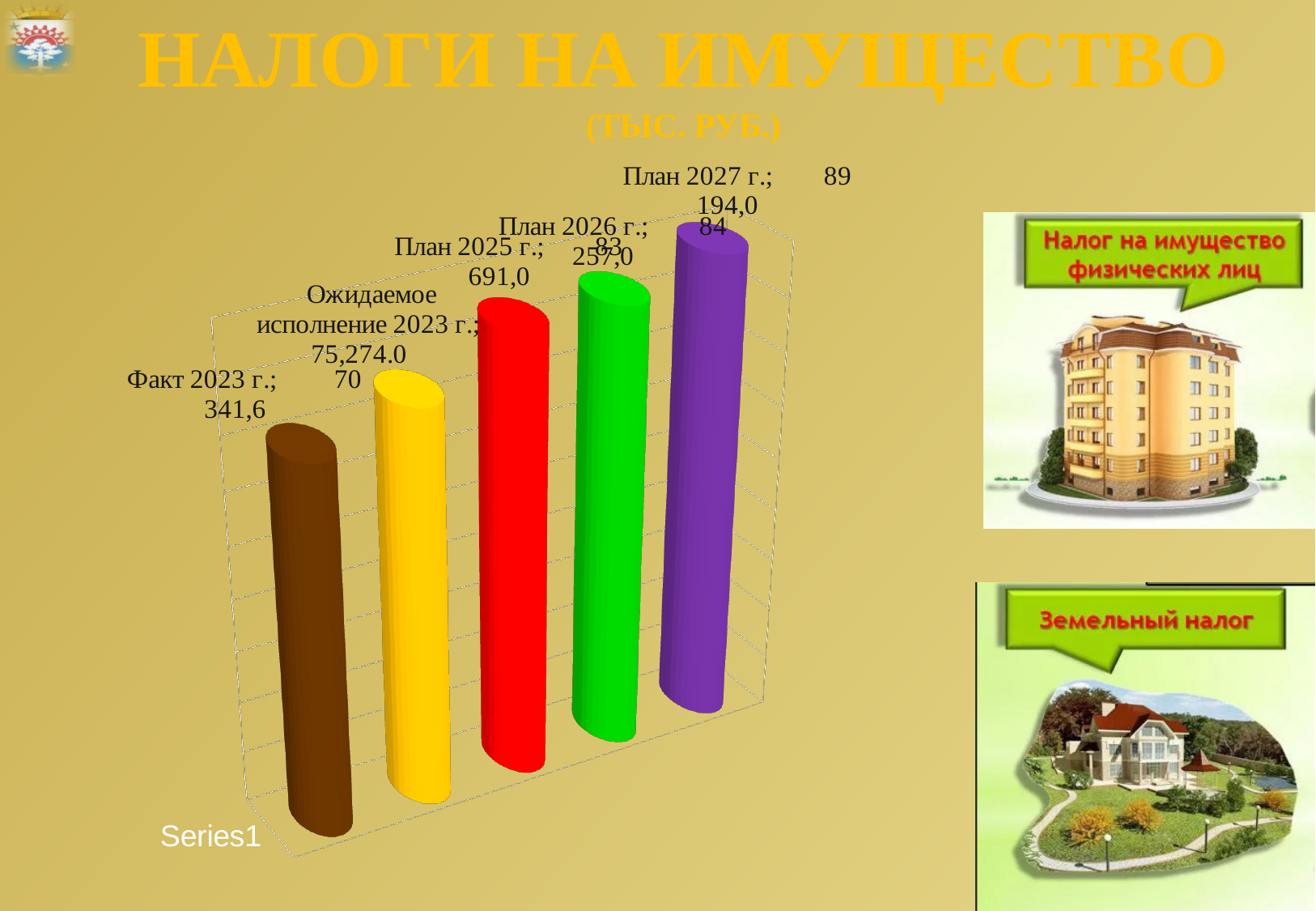
What unit is given in the chart subtitle under the slide title? ТЫС. РУБ. What value is labelled for План 2027 г.? 89 194,0 Which is larger, the bar for План 2026 г. or the bar for Ожидаемое исполнение 2023 г.? План 2026 г. What value is labelled for Факт 2023 г.? 70 341,6 What is the series name shown at the bottom of the chart? Series1 Which category has the shortest bar in the chart? Факт 2023 г. How many bars are plotted in the chart? 5 Which is larger, the bar for План 2025 г. or the bar for Факт 2023 г.? План 2025 г. What colour is the bar for План 2027 г.? purple Which category has the tallest bar in the chart? План 2027 г. Do the bar values rise or fall from Факт 2023 г. to План 2027 г.? rise What kind of chart is shown on the slide? bar chart